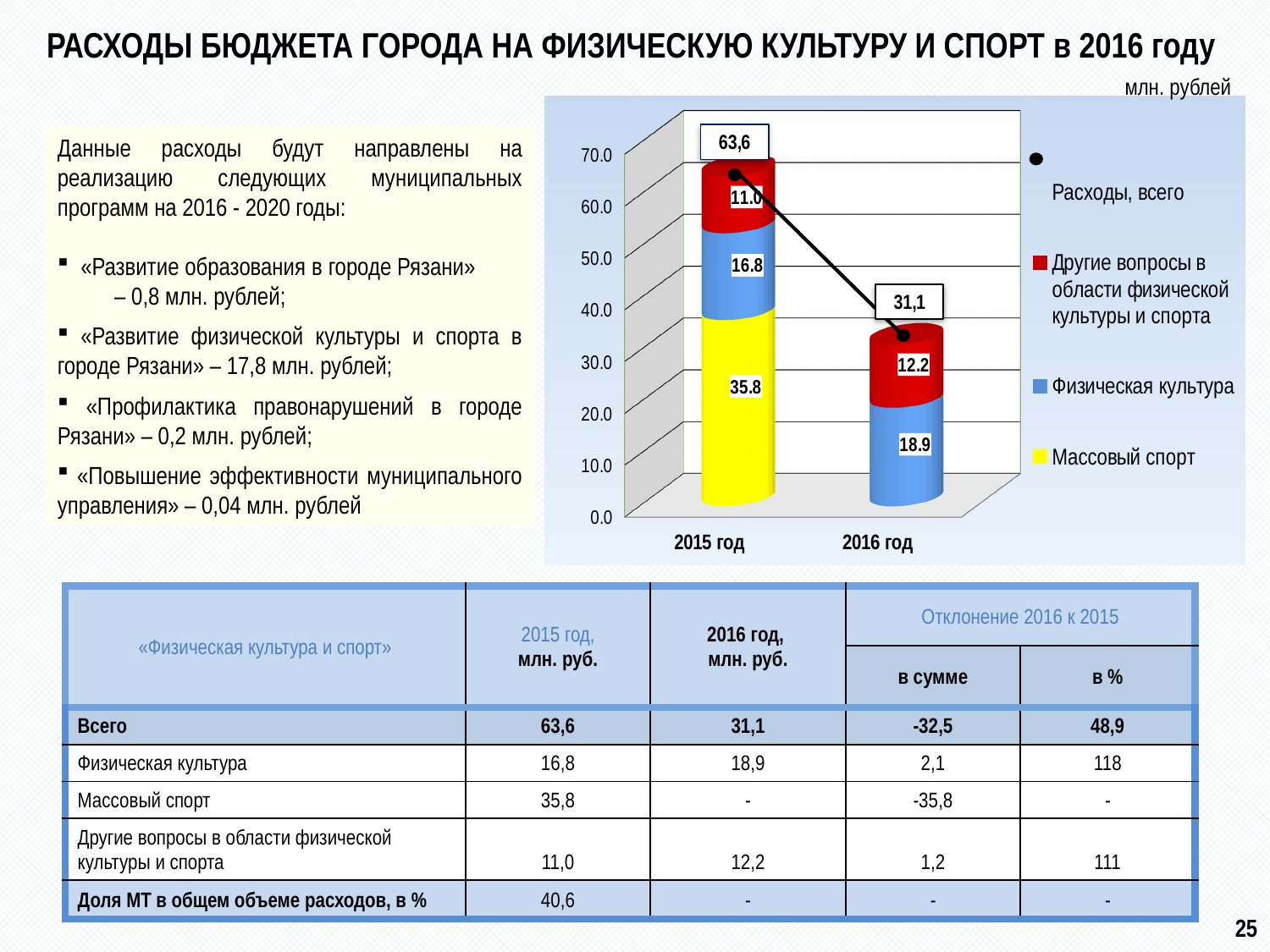
How many year categories are shown on the x axis of the chart? 2 How many entries does the chart legend list? 4 What type of chart is shown on the slide? bar chart What is the value of Массовый спорт for 2015 год in the chart? 35.8 What is the value of Другие вопросы в области физической культуры и спорта for 2015 год in the chart? 11.0 Which segment is the largest in the 2015 год stacked bar? Массовый спорт What is the total Расходы, всего value shown for 2016 год in the chart? 31,1 Does the total expenditure fall or rise from 2015 год to 2016 год in the chart? fall What is the difference between the total expenditure for 2015 год and 2016 год in the chart? 32,5 What is the value of Физическая культура for 2016 год in the chart? 18.9 Which year has the higher total expenditure in the chart, 2015 год or 2016 год? 2015 год What unit is indicated above the chart? млн. рублей